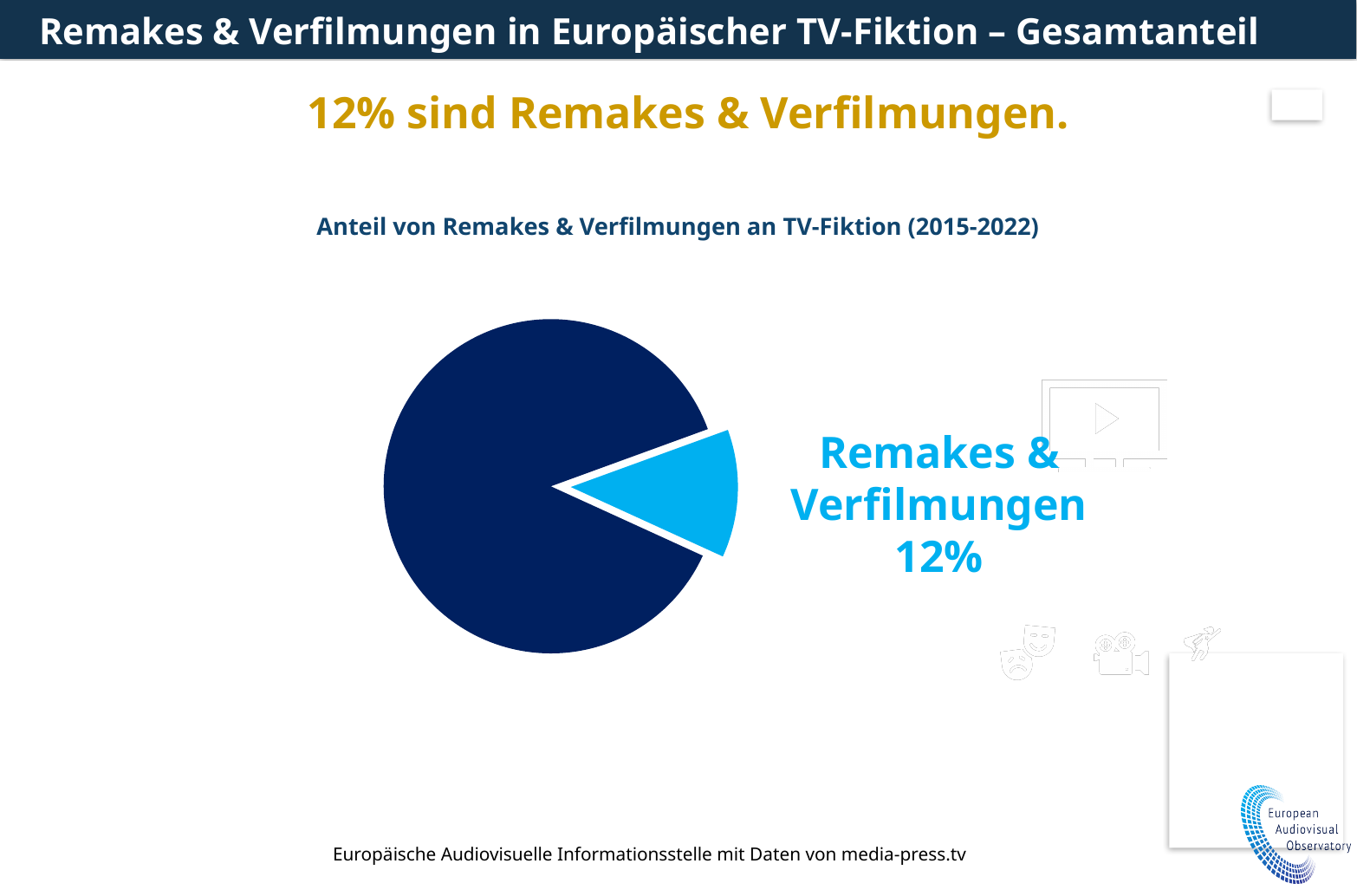
Which time period does the pie chart cover according to its title? 2015-2022 Which slice of the pie chart is the smallest? Remakes & Verfilmungen How many slices does the pie chart have? 2 What kind of chart is shown on the slide? pie chart What share of TV fiction do Remakes & Verfilmungen account for according to the pie chart? 12% What share of the pie is not Remakes & Verfilmungen? 88% What value is printed next to the light blue slice of the pie chart? 12% What is the title of the pie chart? Anteil von Remakes & Verfilmungen an TV-Fiktion (2015-2022) What colour is the Remakes & Verfilmungen slice in the pie chart? light blue Is the Remakes & Verfilmungen slice larger or smaller than the other slice of the pie? smaller Which slice of the pie chart is the largest: the labelled Remakes & Verfilmungen slice or the unlabelled dark blue slice? the unlabelled dark blue slice